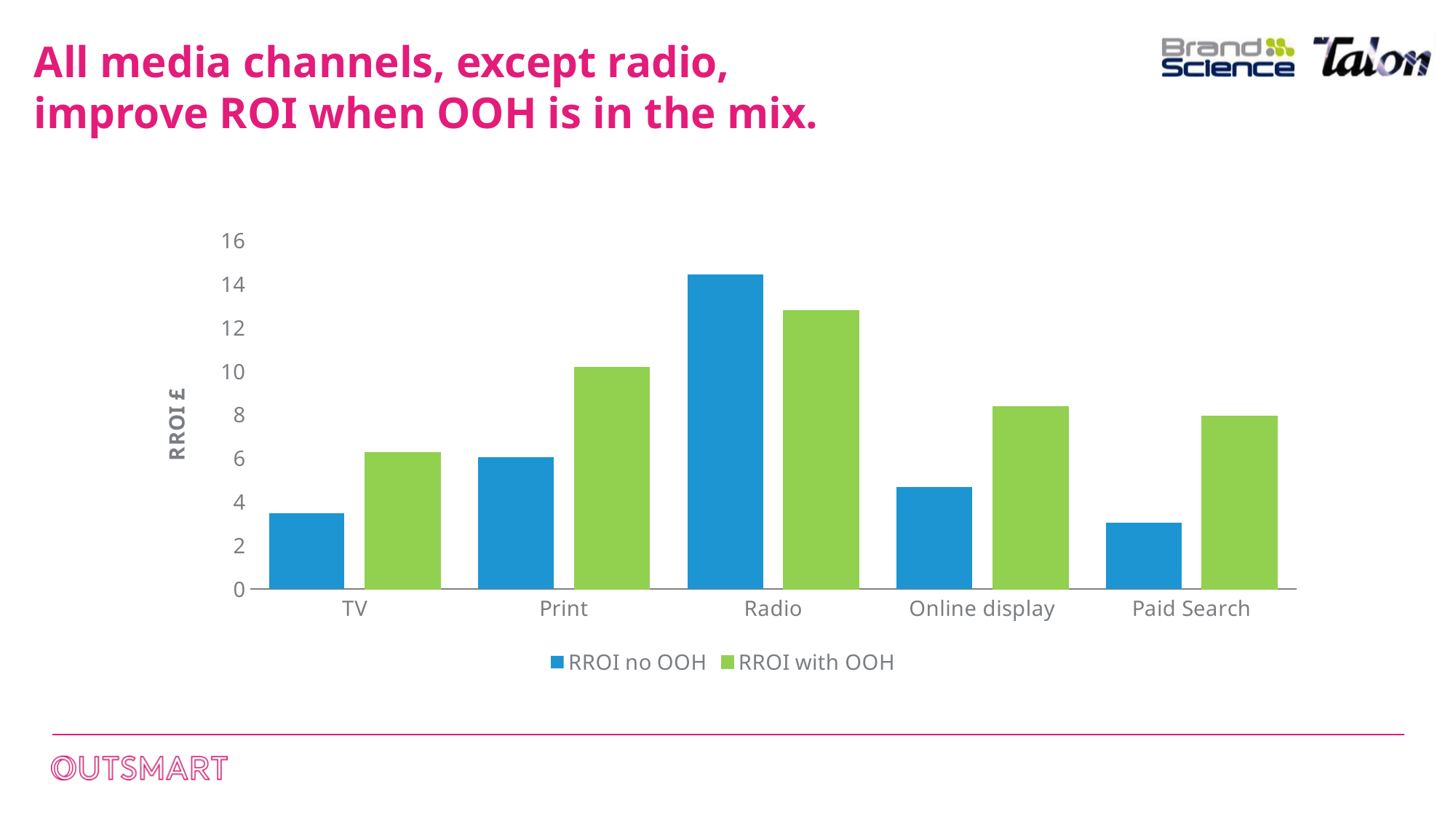
How many series does the chart's legend list? 2 Is the RROI no OOH value for Radio greater or less than 12? greater How many media channels are shown on the x axis of the chart? 5 What kind of chart is shown on the slide? bar chart For Print, which is larger: RROI no OOH or RROI with OOH? RROI with OOH Which media channel has the highest RROI with OOH value? Radio Is the RROI no OOH value for TV greater or less than 4? less Which is larger: the RROI with OOH value for Print or for Online display? Print Which media channel has the highest RROI no OOH value? Radio Which media channel has the lowest RROI with OOH value? TV For Radio, which is larger: RROI no OOH or RROI with OOH? RROI no OOH What is the label on the chart's vertical axis? RROI £